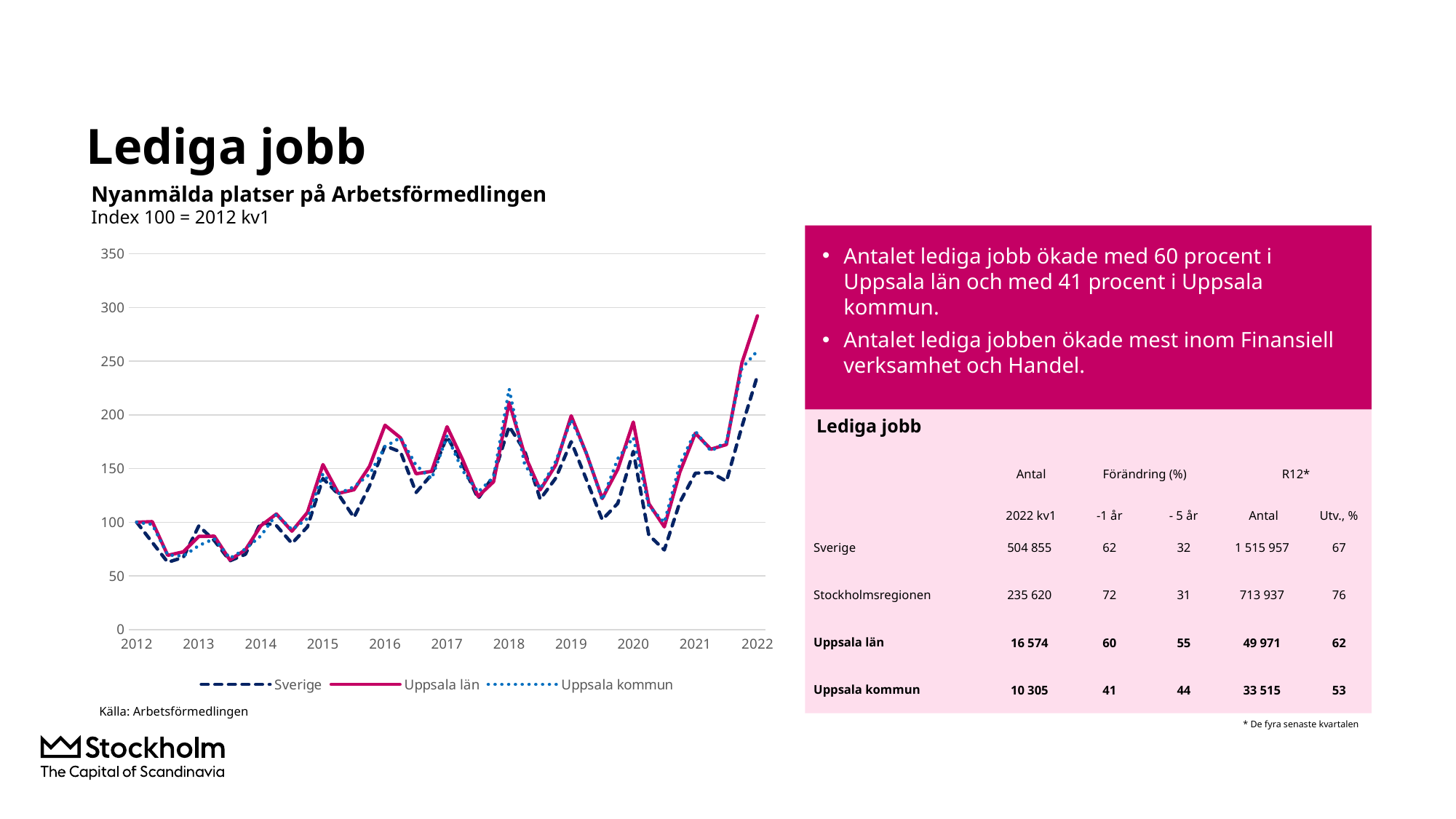
Which series has the highest value at the end of the chart in 2022? Uppsala län What is the title of the chart? Nyanmälda platser på Arbetsförmedlingen Is the value for Sverige at 2022 greater or less than 250? less Is the value for Uppsala län at 2022 greater or less than 250? greater How many year labels are shown on the x axis? 11 What kind of chart is shown on the slide? line chart Is the peak value for Uppsala kommun in 2018 greater or less than 200? greater What is the index value of the series at the base period 2012 kv1? 100 Which series are listed in the chart legend? Sverige, Uppsala län, Uppsala kommun At 2022, which is larger: the value for Uppsala län or the value for Sverige? Uppsala län How many series does the chart legend list? 3 Which series has the lowest value at the end of the chart in 2022? Sverige